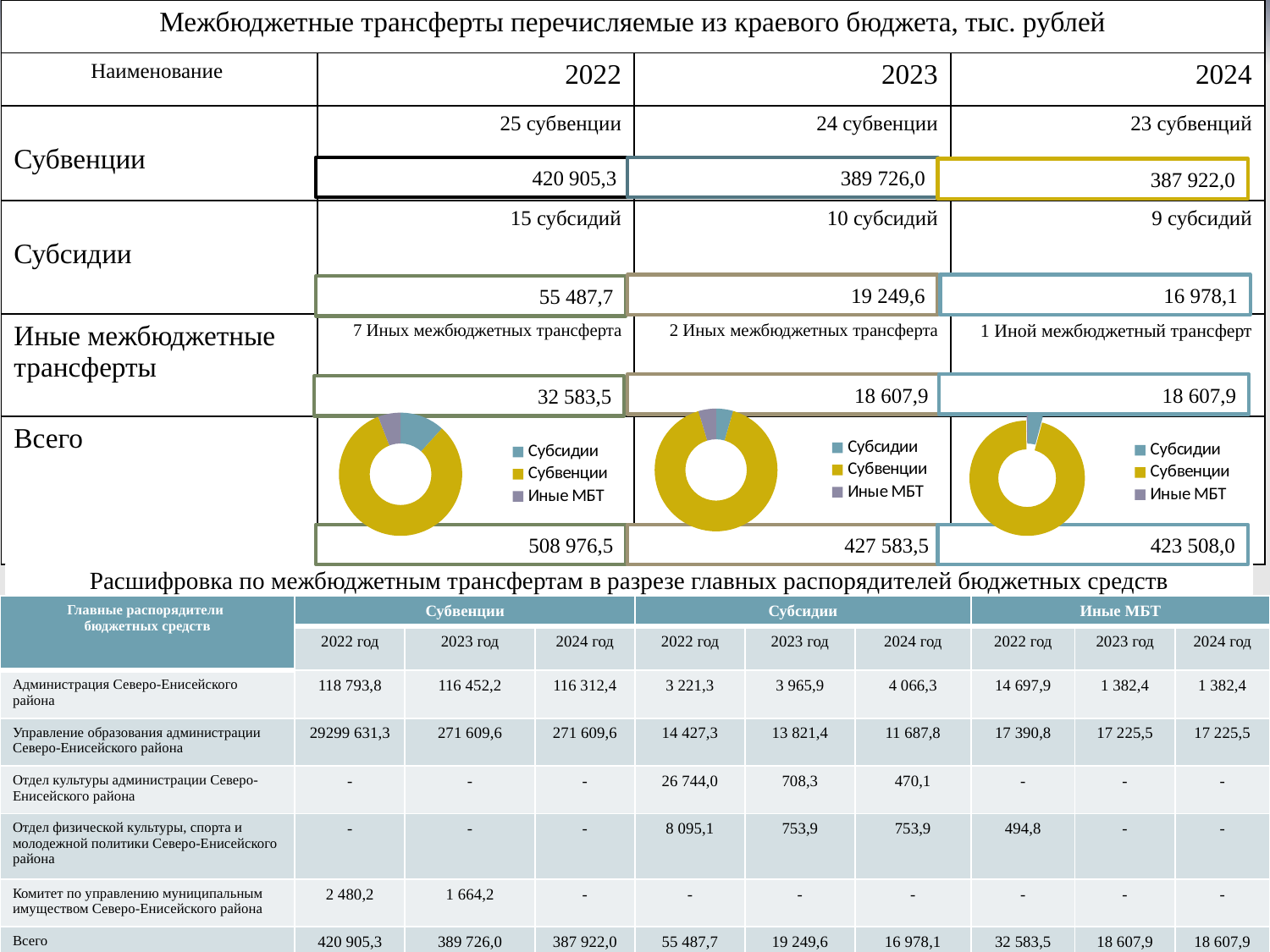
In the 2022 pie chart, which category has the largest slice? Субвенции How many entries does the legend of the 2022 pie chart list? 3 What is the value of Иные МБТ shown for the 2024 chart? 18 607,9 In the 2022 pie chart, which is larger: Субсидии or Иные МБТ? Субсидии What kind of chart is used in the 'Всего' row for each year? pie (donut) chart What is the total (Всего) shown under the 2022 pie chart? 508 976,5 What is the value of Субвенции shown for the 2022 chart? 420 905,3 What are the legend entries of the 2023 pie chart? Субсидии, Субвенции, Иные МБТ Do the totals (Всего) under the pie charts rise or fall from 2022 to 2024? fall For 2022, what is the difference between Субвенции and Субсидии? 365 417,6 In the 2022 pie chart, which category has the smallest slice? Иные МБТ How many pie charts are shown on the slide? 3